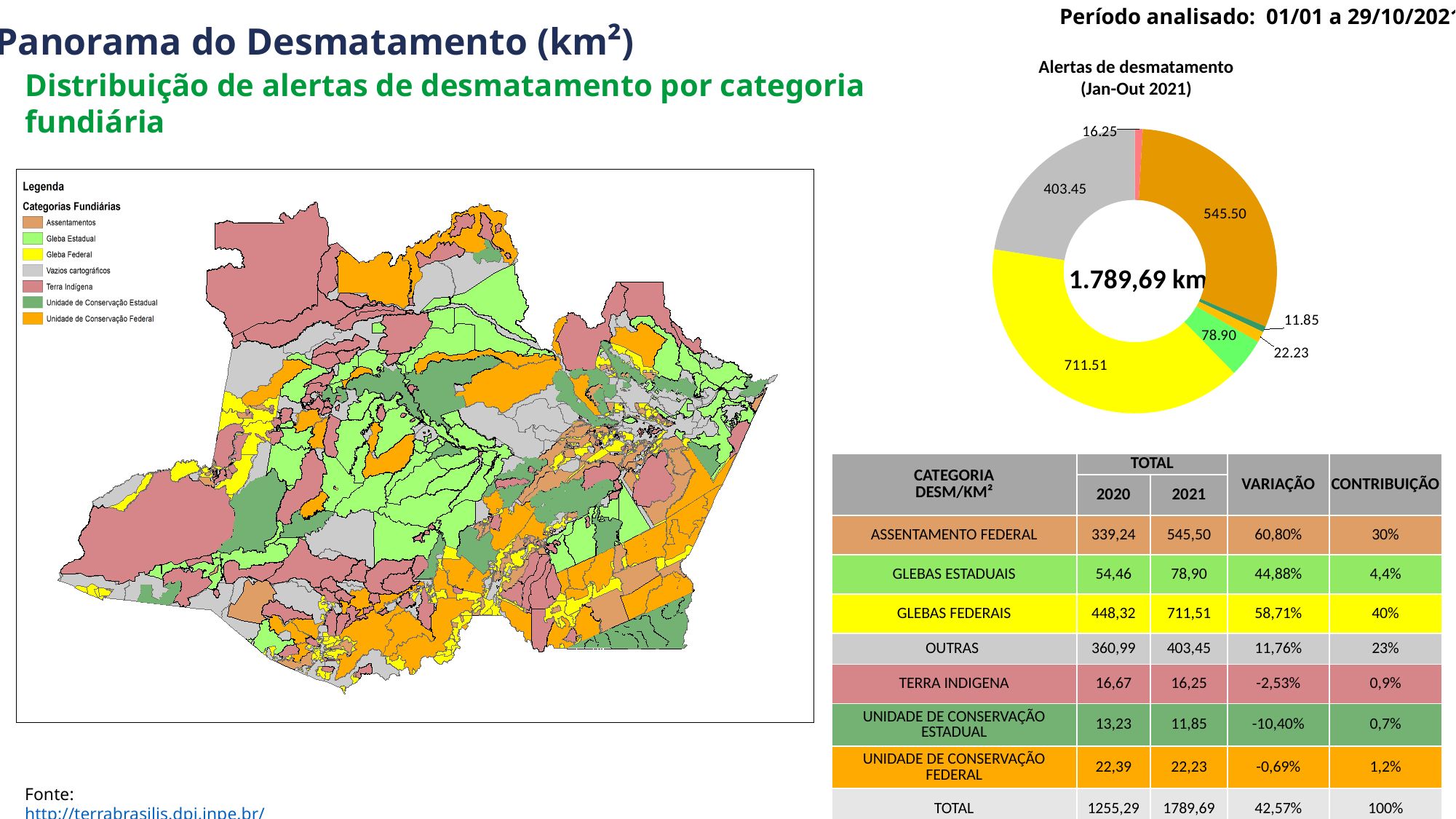
What is the title of the donut chart on the slide? Alertas de desmatamento (Jan-Out 2021) How many slices does the 'Alertas de desmatamento' chart have? 7 In the 'Alertas de desmatamento' chart, which slice has the largest value? 711.51 (yellow) In the 'Alertas de desmatamento' chart, what is the value of the grey slice? 403.45 In the 'Alertas de desmatamento' chart, which slice has the smallest value? 11.85 (dark green) In the 'Alertas de desmatamento' chart, what is the value of the yellow slice? 711.51 In the 'Alertas de desmatamento' chart, what is the value of the light green slice? 78.90 In the 'Alertas de desmatamento' chart, which is larger: the grey slice or the light green slice? The grey slice (403.45) What total value is shown in the centre of the 'Alertas de desmatamento' chart? 1.789,69 km In the 'Alertas de desmatamento' chart, what is the difference between the yellow slice (711.51) and the brown-orange slice (545.50)? 166.01 What kind of chart is 'Alertas de desmatamento (Jan-Out 2021)'? Donut (pie) chart In the 'Alertas de desmatamento' chart, what is the value of the pink slice? 16.25